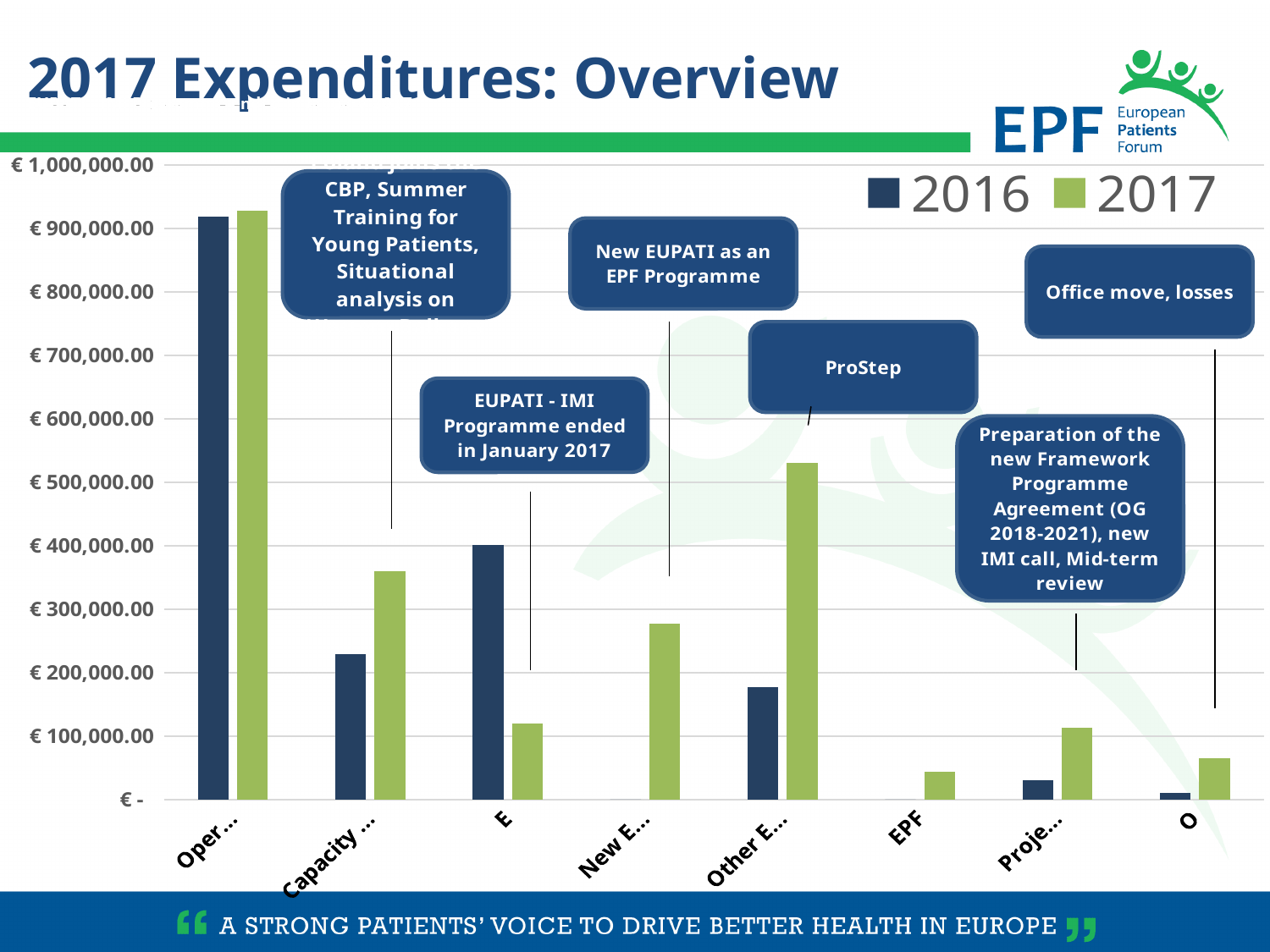
For the third category (E), which series has the larger value, 2016 or 2017? 2016 Which category has the tallest 2017 bar? the first category (Oper...) Is the 2017 value for EPF greater or less than €100,000.00? less Which category has the lowest 2017 bar? EPF What kind of chart is shown on the slide? bar chart How many series does the legend list? 2 What are the two series named in the legend? 2016 and 2017 What is the title of the slide containing the chart? 2017 Expenditures: Overview For the second category (Capacity ...), which series has the larger value, 2016 or 2017? 2017 Is the 2017 value for the fifth category (Other E...) greater or less than €500,000.00? greater How many categories are shown along the x axis? 8 Is the 2016 value for the third category (E) greater or less than €300,000.00? greater